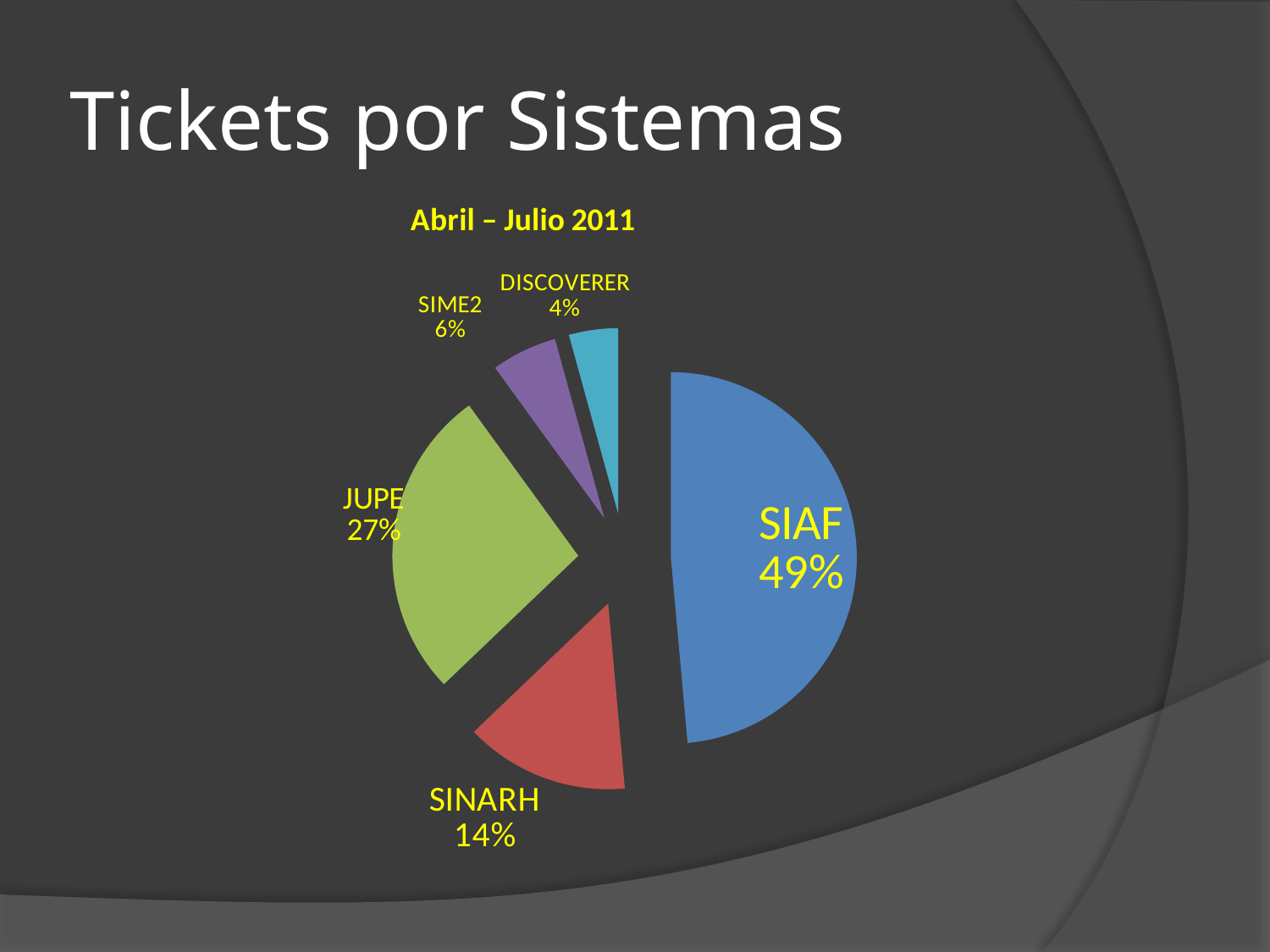
What is the difference in percentage points between SIAF and JUPE? 22 What percentage is shown for SIME2? 6% How many systems are shown in the pie chart? 5 What is the title of the chart? Abril – Julio 2011 Which system has the smallest share of tickets? DISCOVERER What share of tickets does SIAF account for? 49% Which has a larger share, SINARH or SIME2? SINARH What percentage is shown for JUPE? 27% What percentage is shown for DISCOVERER? 4% Which system has the largest share of tickets? SIAF What percentage is shown for SINARH? 14% What kind of chart is shown on the slide? Pie chart